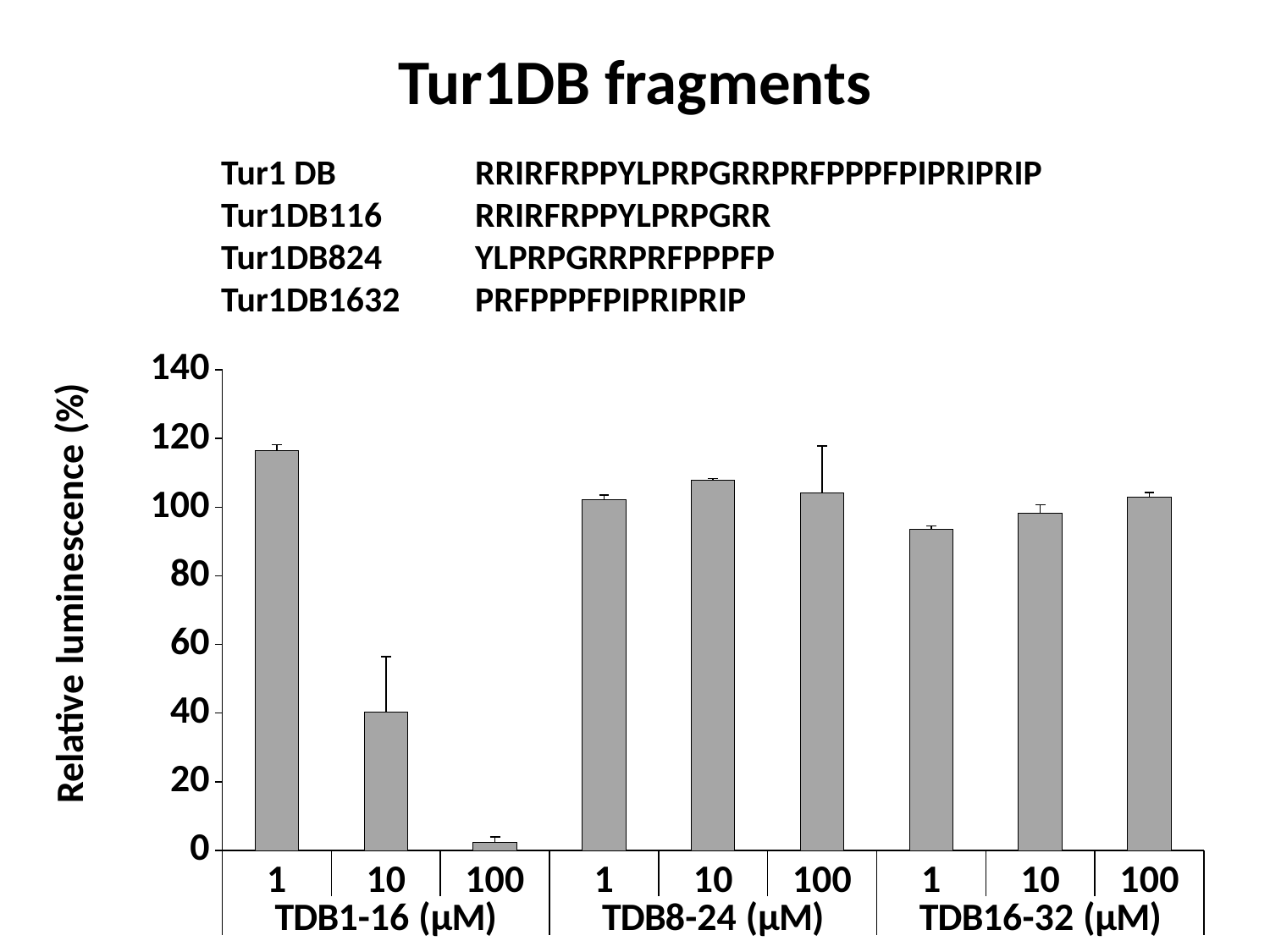
What kind of chart is shown on the slide? bar chart How many bars are plotted in the chart? 9 Which bar has the lowest relative luminescence? TDB1-16 at 100 µM Is the value for TDB16-32 at 1 µM greater or less than 100? less How many peptide groups are shown along the x axis of the chart? 3 Is the value for TDB1-16 at 10 µM greater or less than 60? less Is the value for TDB1-16 at 1 µM greater or less than 100? greater Which is larger, the value for TDB8-24 at 10 µM or the value for TDB16-32 at 1 µM? TDB8-24 at 10 µM Which bar has the highest relative luminescence? TDB1-16 at 1 µM What is the label of the y axis? Relative luminescence (%) Do the values for TDB1-16 rise or fall as the concentration increases from 1 to 100 µM? fall